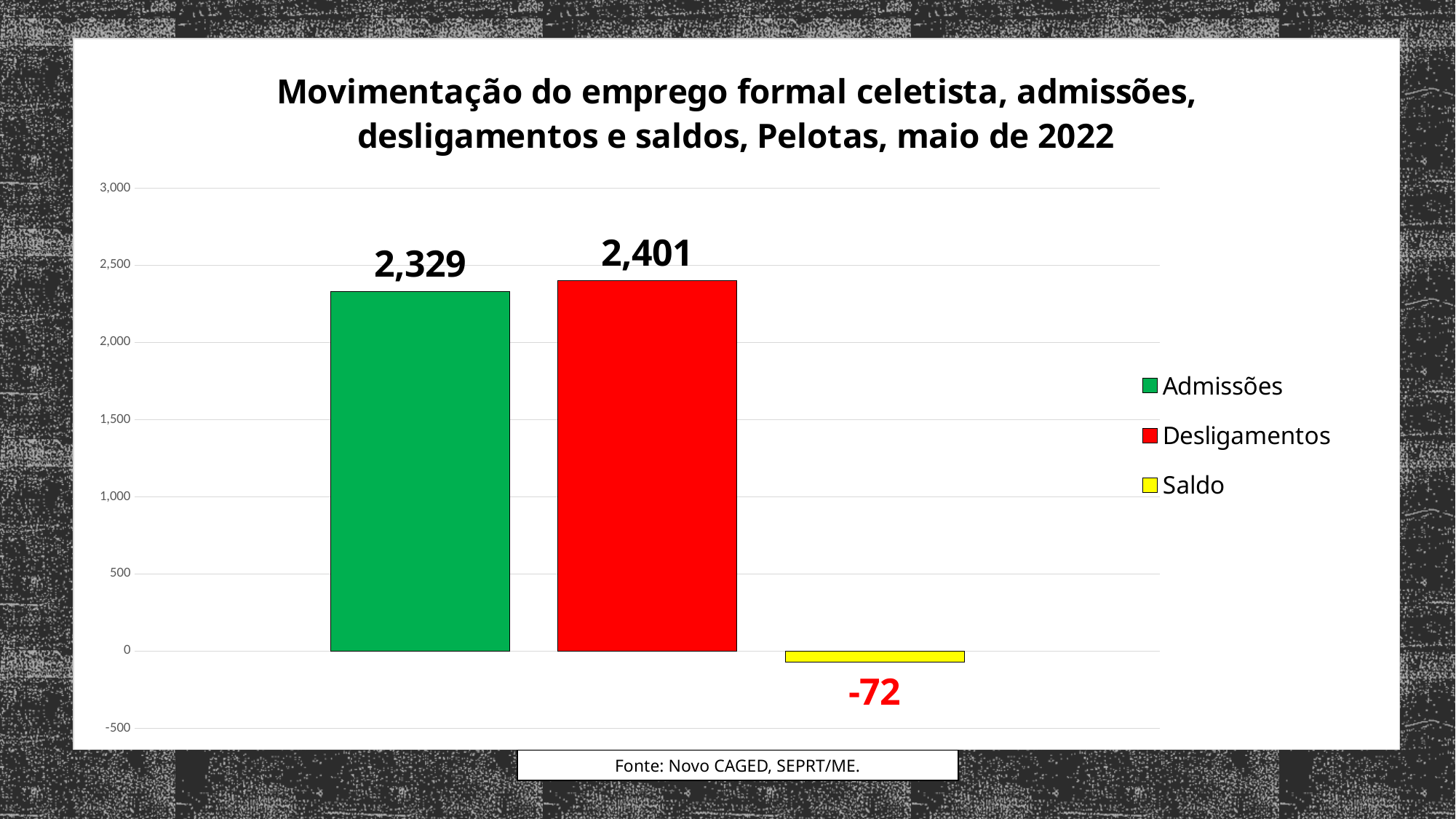
Which is larger, Admissões or Desligamentos? Desligamentos What is the value for Admissões? 2,329 What is the value for Saldo? -72 What source is cited below the chart? Fonte: Novo CAGED, SEPRT/ME. What kind of chart is shown on the slide? bar chart Which series has the lowest value? Saldo Is the value for Admissões greater or less than 2,000? greater What is the difference between Desligamentos and Admissões? 72 What colour is the bar for Saldo? yellow Which series has the highest value? Desligamentos How many series does the legend list? 3 What is the value for Desligamentos? 2,401